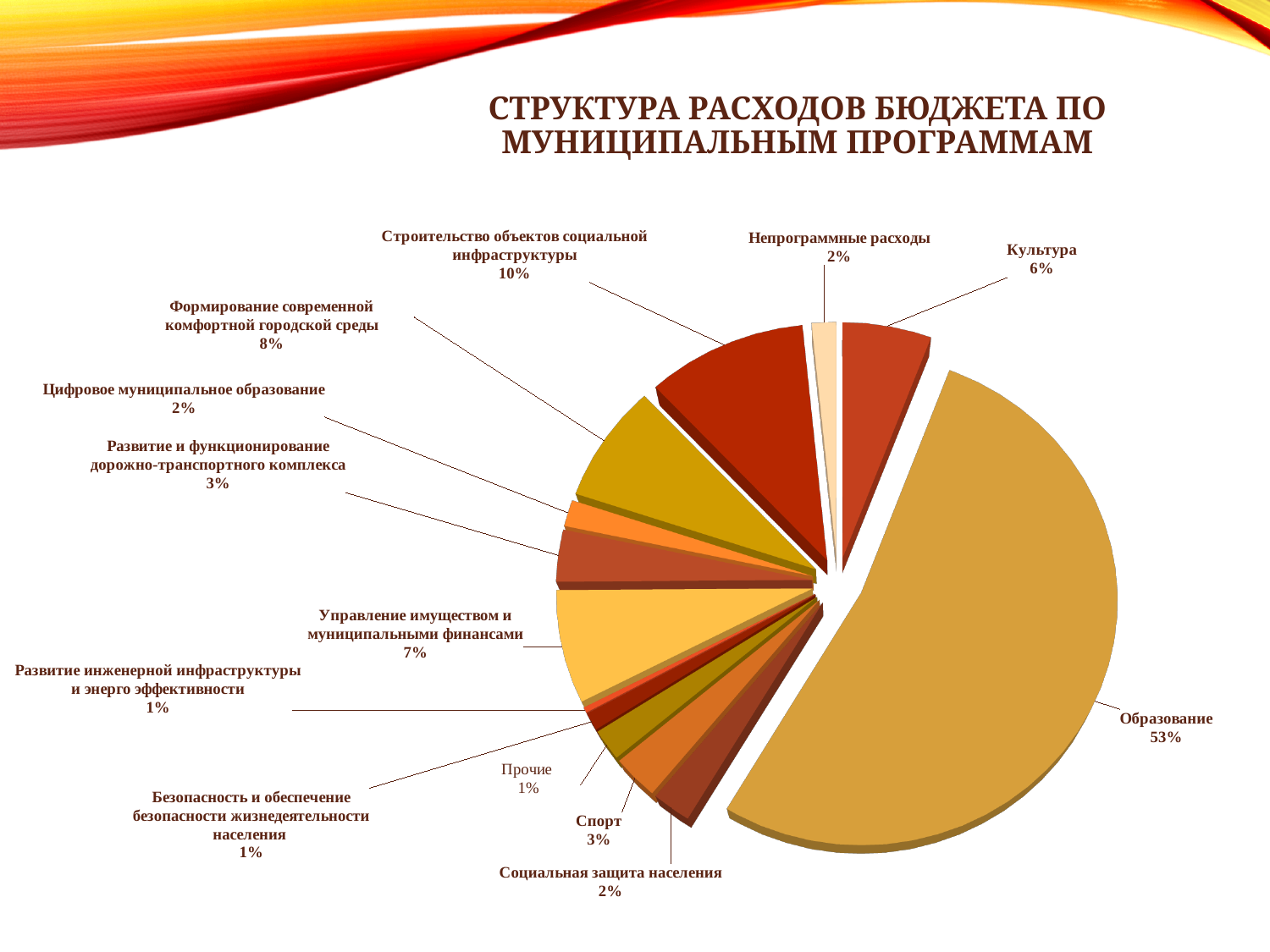
Which category has the largest share of the pie? Образование What percentage is shown for Управление имуществом и муниципальными финансами? 7% Which is larger, the share for Спорт or the share for Культура? Культура What share of the budget expenditure goes to Образование? 53% What is the difference between the shares of Образование and Строительство объектов социальной инфраструктуры? 43% What percentage is shown for Непрограммные расходы? 2% What percentage is shown for Культура? 6% How many slices does the pie chart have? 13 What percentage is shown for Строительство объектов социальной инфраструктуры? 10% What kind of chart is shown on the slide? Pie chart What is the title of the chart? СТРУКТУРА РАСХОДОВ БЮДЖЕТА ПО МУНИЦИПАЛЬНЫМ ПРОГРАММАМ What percentage is shown for Формирование современной комфортной городской среды? 8%